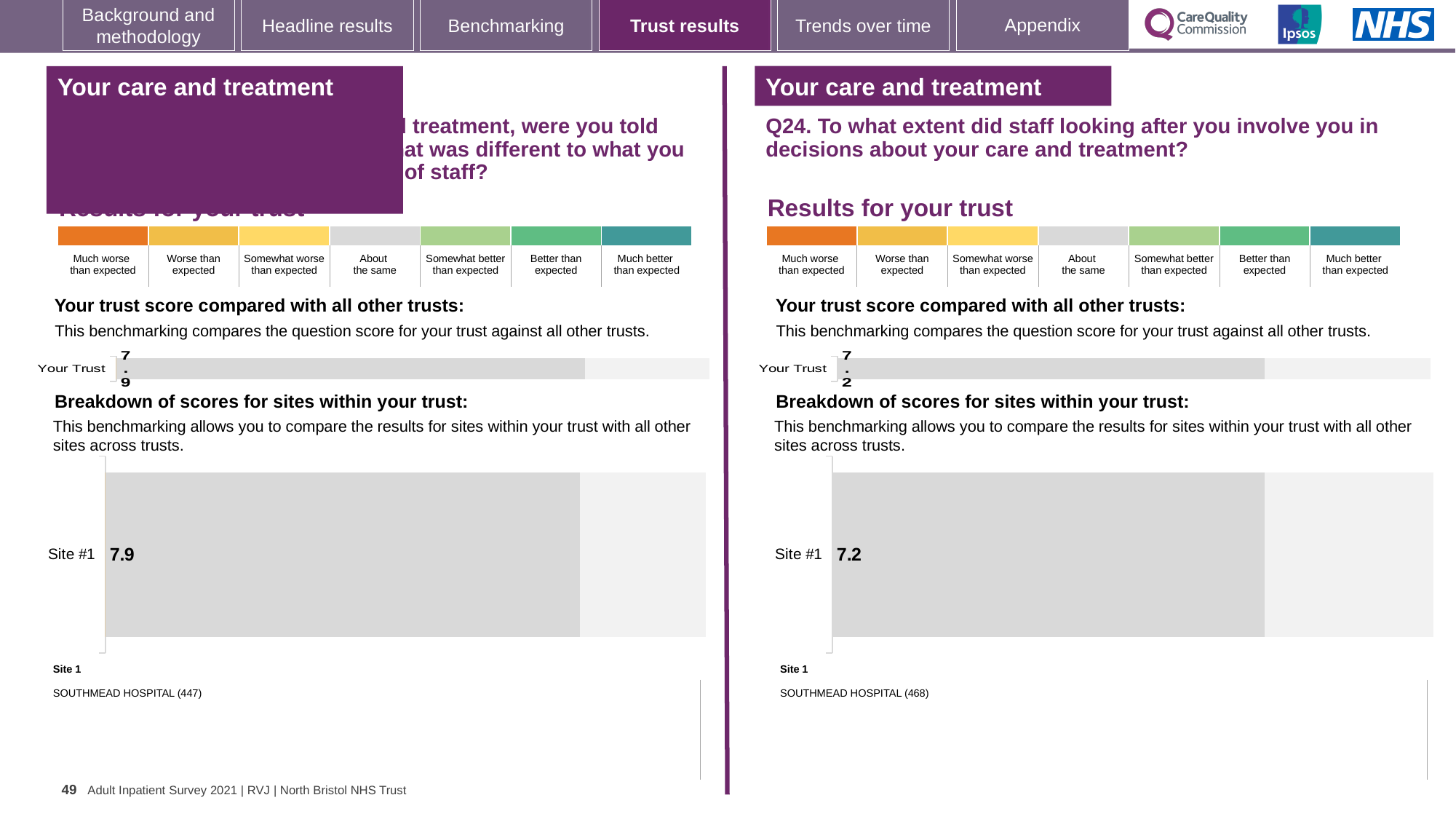
In the right-hand 'Breakdown of scores for sites within your trust' chart (Q24), what is the score for Site #1? 7.2 How many sites are shown in the left-hand 'Breakdown of scores for sites within your trust' chart? 1 In the left-hand 'Your trust score compared with all other trusts' chart, what is the score shown for Your Trust? 7.9 What is the difference between the Your Trust score in the left-hand trust chart and the Your Trust score in the right-hand trust chart? 0.7 What kind of chart is used for the 'Breakdown of scores for sites within your trust' on the left-hand side? Bar chart Which is larger: the Your Trust score in the left-hand trust chart or the Your Trust score in the right-hand trust chart? The left-hand chart (7.9) In the right-hand site breakdown chart, which hospital is listed as Site 1? SOUTHMEAD HOSPITAL (468) Which is larger: the Site #1 score in the left-hand site breakdown chart or the Site #1 score in the right-hand site breakdown chart? The left-hand chart (7.9) How many sites are shown in the right-hand 'Breakdown of scores for sites within your trust' chart? 1 In the left-hand 'Breakdown of scores for sites within your trust' chart, what is the score for Site #1? 7.9 In the right-hand 'Your trust score compared with all other trusts' chart (Q24), what is the score shown for Your Trust? 7.2 Which question number do the right-hand charts relate to? Q24